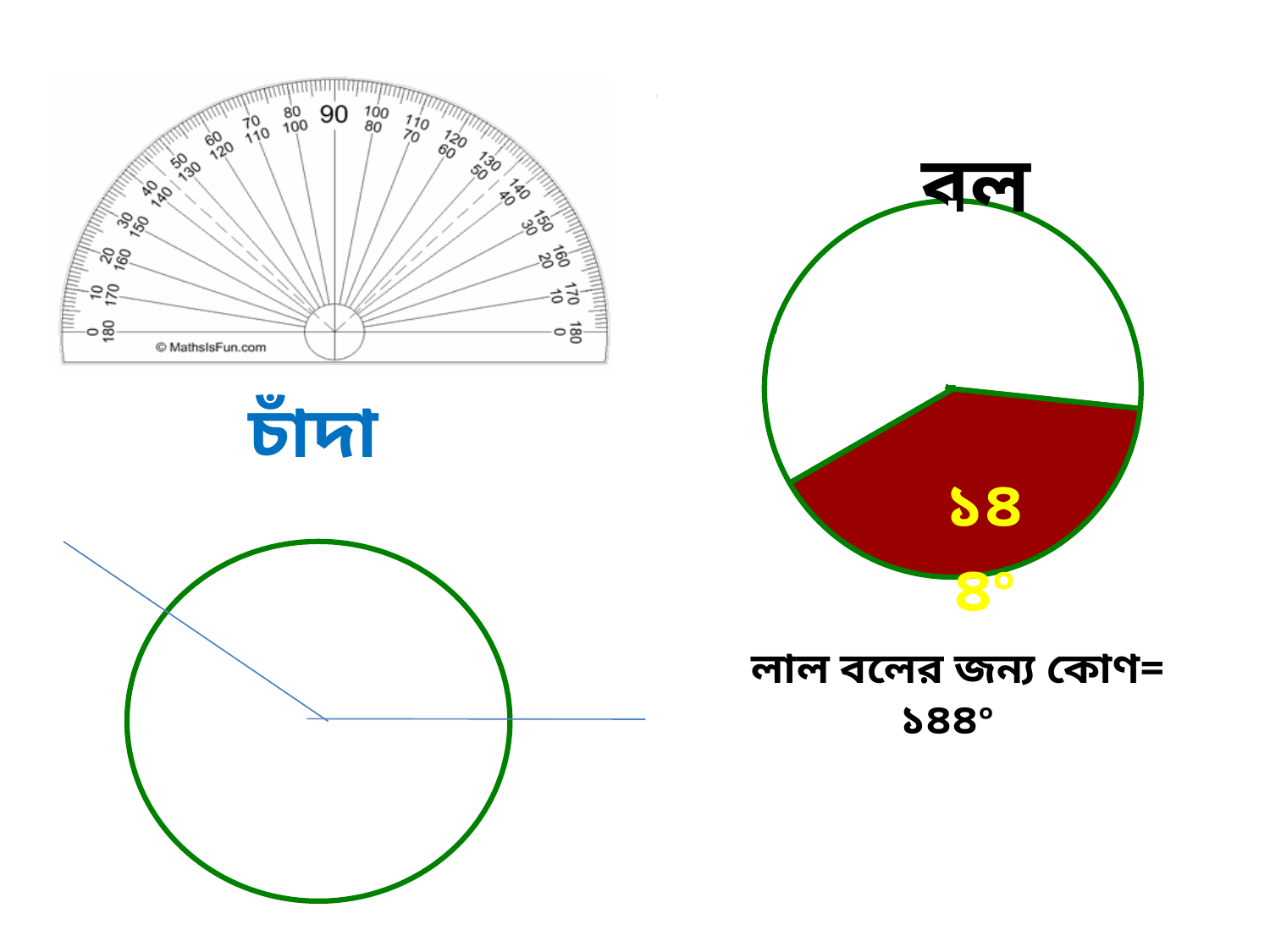
What kind of chart is the circle with the shaded sector on the right of the slide? pie chart Is the angle of the red sector in the right-hand circle greater or less than 90°? greater What colour is the shaded sector in the circle diagram on the right? red How many shaded sectors are there in the circle diagram on the right? 1 What is the title written above the circle diagram on the right? বল In the circle diagram titled "বল" on the right, what angle is printed for the red sector? ১৪৪° According to the text below the right-hand circle, what is the angle for the red ball (লাল বল)? ১৪৪°